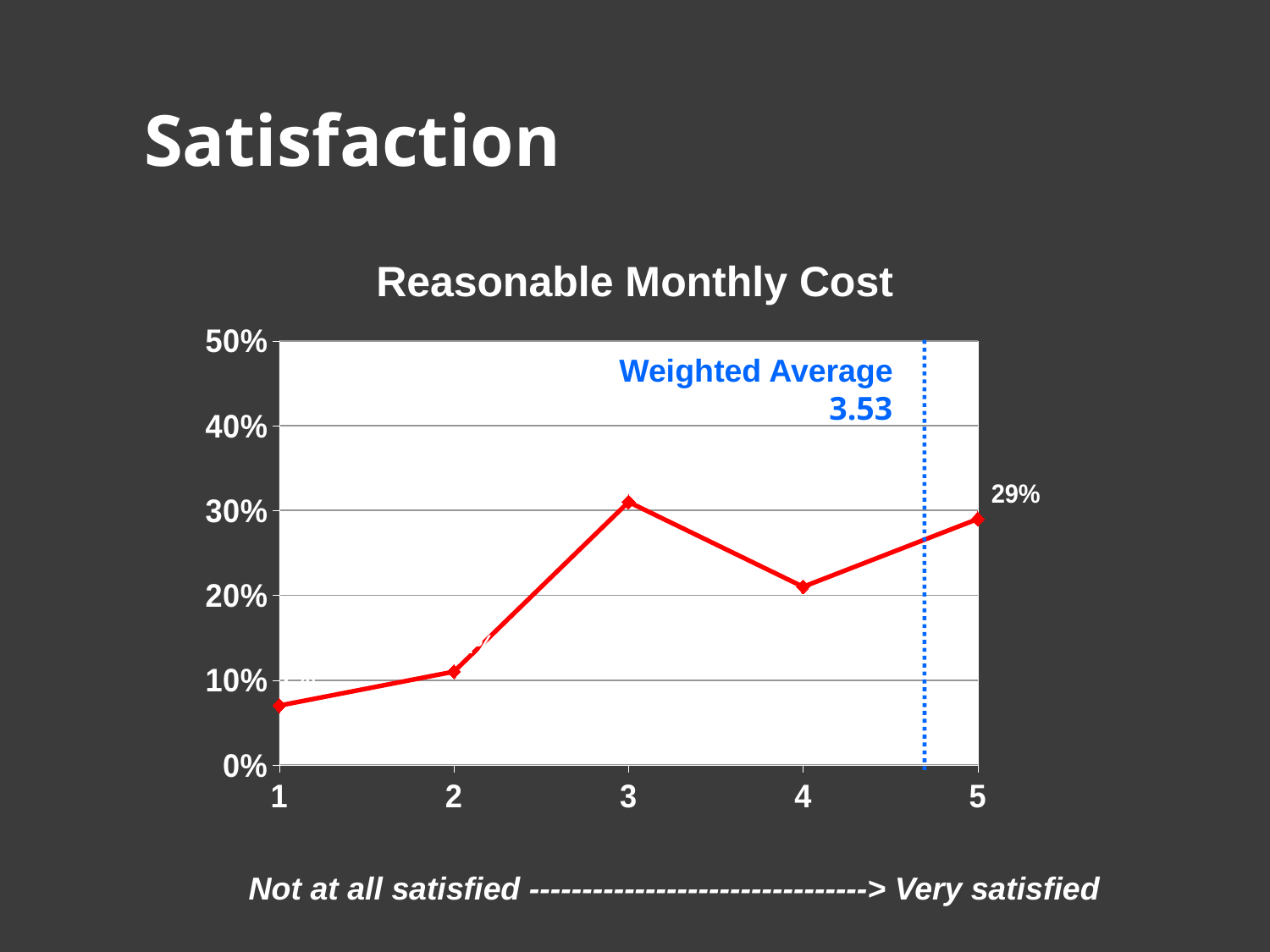
Which has the larger value, category 3 or category 4? 3 Is the value for category 2 greater or less than 20%? less What kind of chart is shown on the slide? Line chart Is the value for category 4 greater or less than 30%? less Is the value for category 1 greater or less than 10%? less What weighted average is annotated on the Reasonable Monthly Cost chart? 3.53 Which category has the lowest value in the Reasonable Monthly Cost chart? 1 Which has the larger value, category 2 or category 4? 4 Which category has the highest value in the Reasonable Monthly Cost chart? 3 What is the value shown for category 5 in the Reasonable Monthly Cost chart? 29% How many data points are plotted on the line in the Reasonable Monthly Cost chart? 5